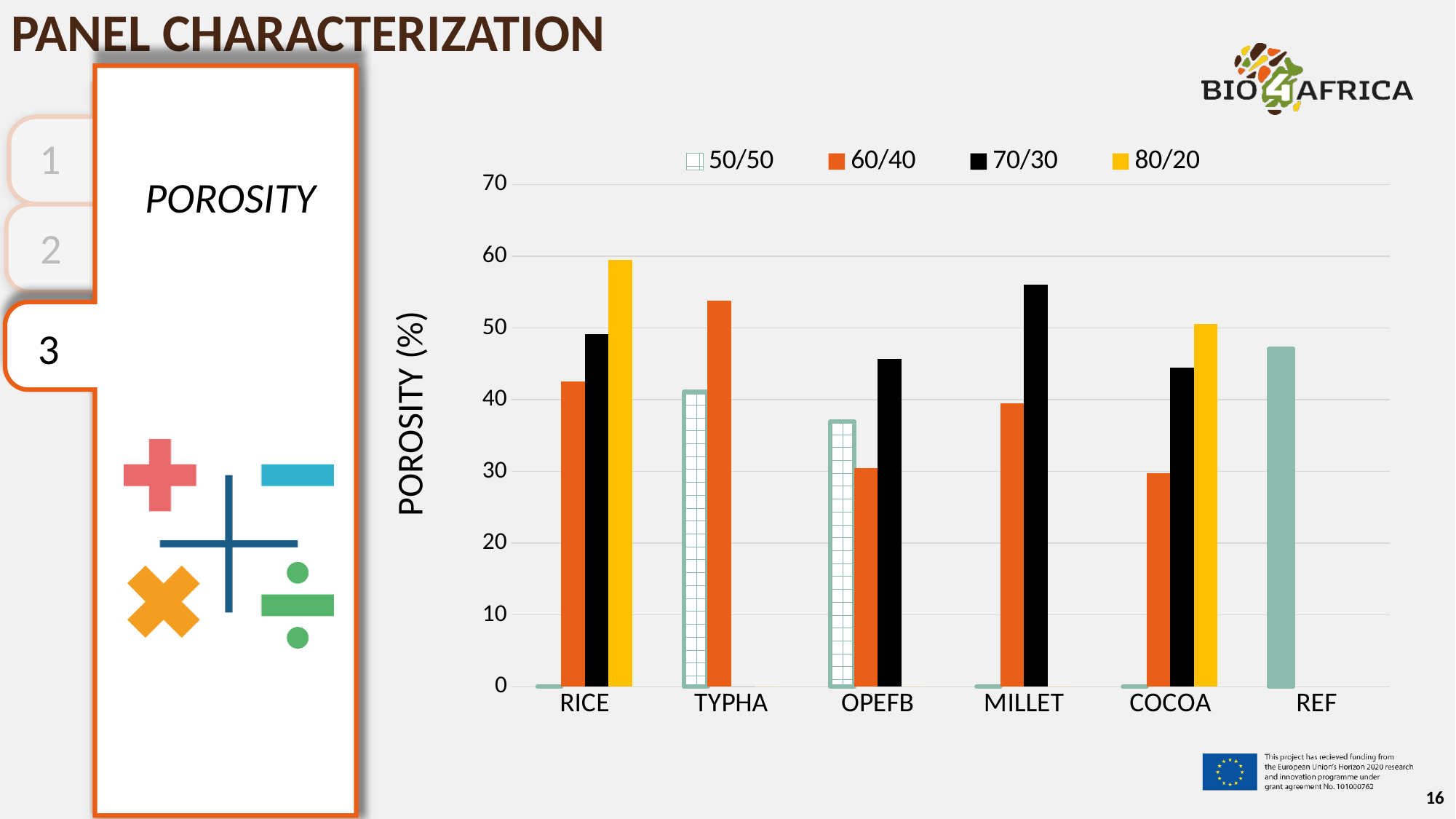
What kind of chart is shown on the slide? bar chart What is the title of the y axis? POROSITY (%) Is the value for REF greater or less than 50? less Which category has the tallest bar in the chart? RICE How many categories are shown on the x axis? 6 For RICE, which series has the highest porosity? 80/20 Which is larger, the 60/40 value for TYPHA or the 60/40 value for RICE? TYPHA Is the 60/40 value for OPEFB greater or less than 40? less Is the 80/20 value for RICE greater or less than 50? greater For MILLET, which series has the highest porosity? 70/30 For OPEFB, which series has the lowest porosity? 60/40 How many series does the legend list? 4